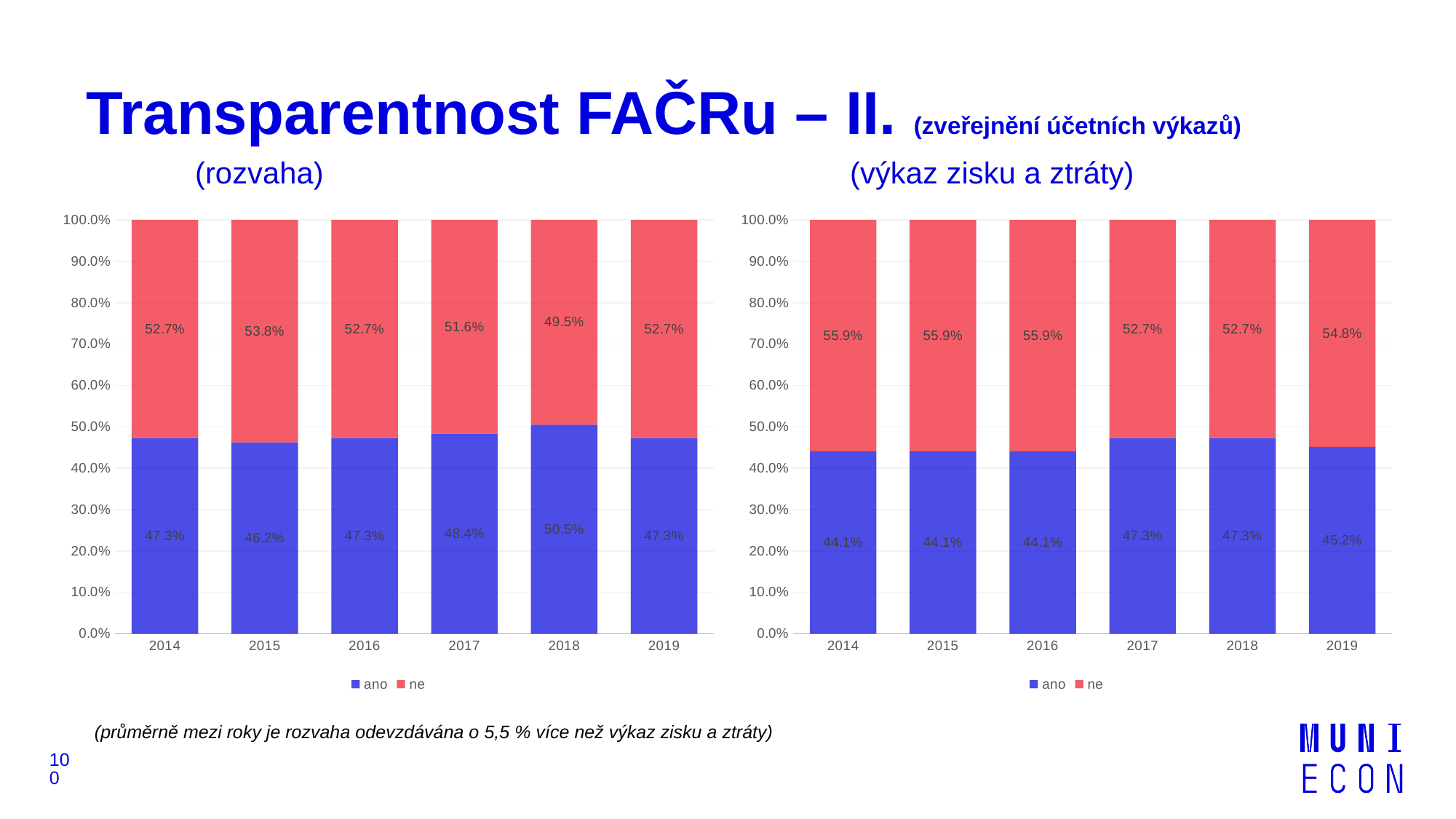
What kind of chart is the left chart (rozvaha)? stacked bar chart How many years are shown on the x axis of the left chart (rozvaha)? 6 In the left chart (rozvaha), which colour represents the "ne" series? red In the right chart (výkaz zisku a ztráty), is the "ano" value for 2016 greater or less than 50.0%? less In the left chart (rozvaha), which year has the lowest "ano" value? 2015 In the left chart (rozvaha), is the "ano" value for 2017 larger or smaller than the "ano" value for 2015? larger In the right chart (výkaz zisku a ztráty), what is the total of the stacked bar for 2017? 100.0% In the right chart (výkaz zisku a ztráty), what is the difference between the "ne" and "ano" values in 2014? 11.8% How many series does the legend of the right chart (výkaz zisku a ztráty) list? 2 In the left chart (rozvaha), what is the value for "ano" in 2018? 50.5% In the right chart (výkaz zisku a ztráty), what is the value for "ne" in 2019? 54.8% In the left chart (rozvaha), which year has the highest "ano" value? 2018